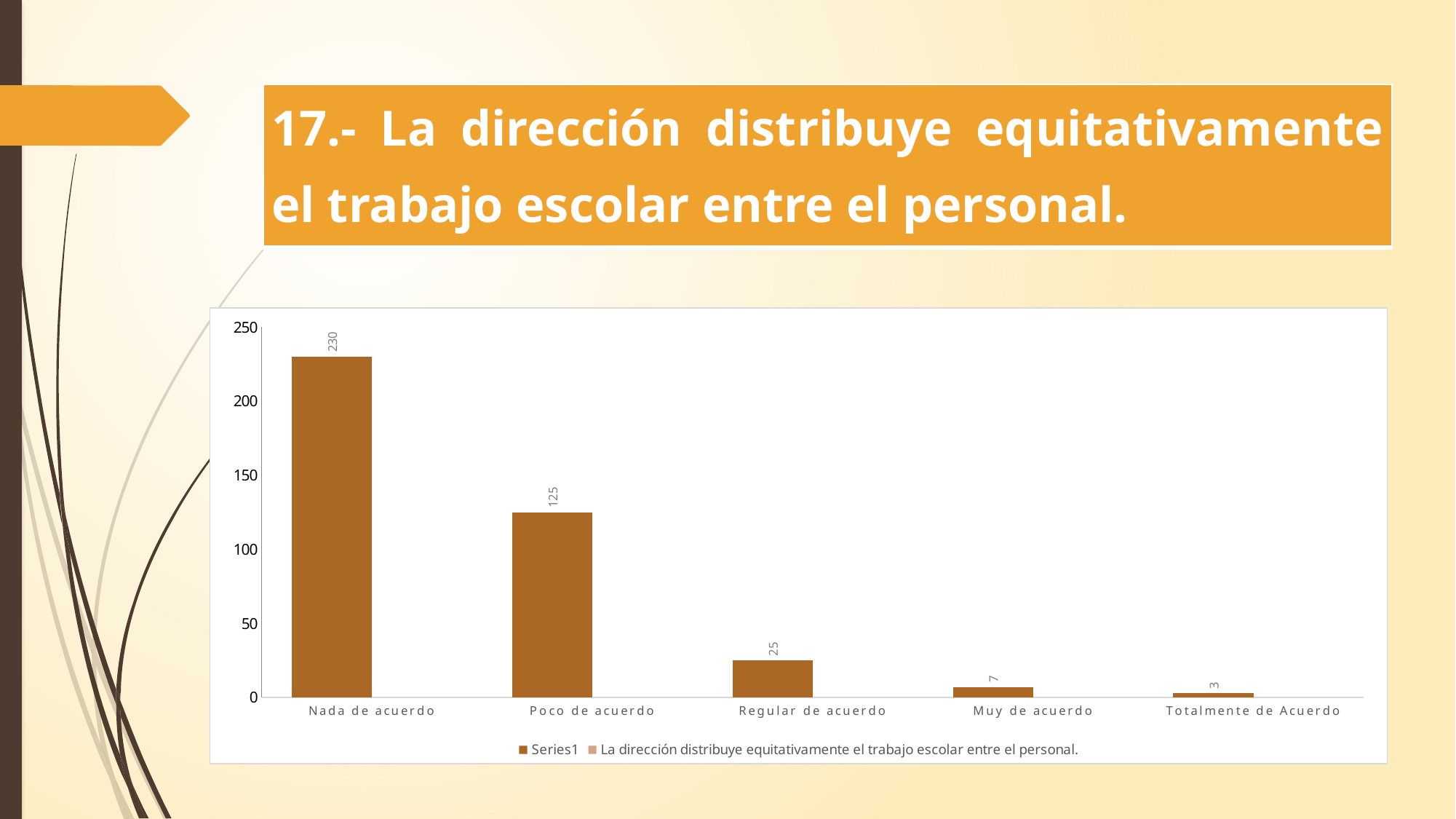
What is the value for Regular de acuerdo? 25 Which category has the highest value? Nada de acuerdo How many categories are shown on the x axis? 5 Do the values rise or fall from left to right along the x axis? Fall What is the difference between the values for Nada de acuerdo and Poco de acuerdo? 105 What is the value for Totalmente de Acuerdo? 3 What is the value for Poco de acuerdo? 125 What kind of chart is shown on the slide? Bar chart Which category has the lowest value? Totalmente de Acuerdo What is the value for Muy de acuerdo? 7 Which is larger, the value for Regular de acuerdo or the value for Muy de acuerdo? Regular de acuerdo What is the value for Nada de acuerdo? 230